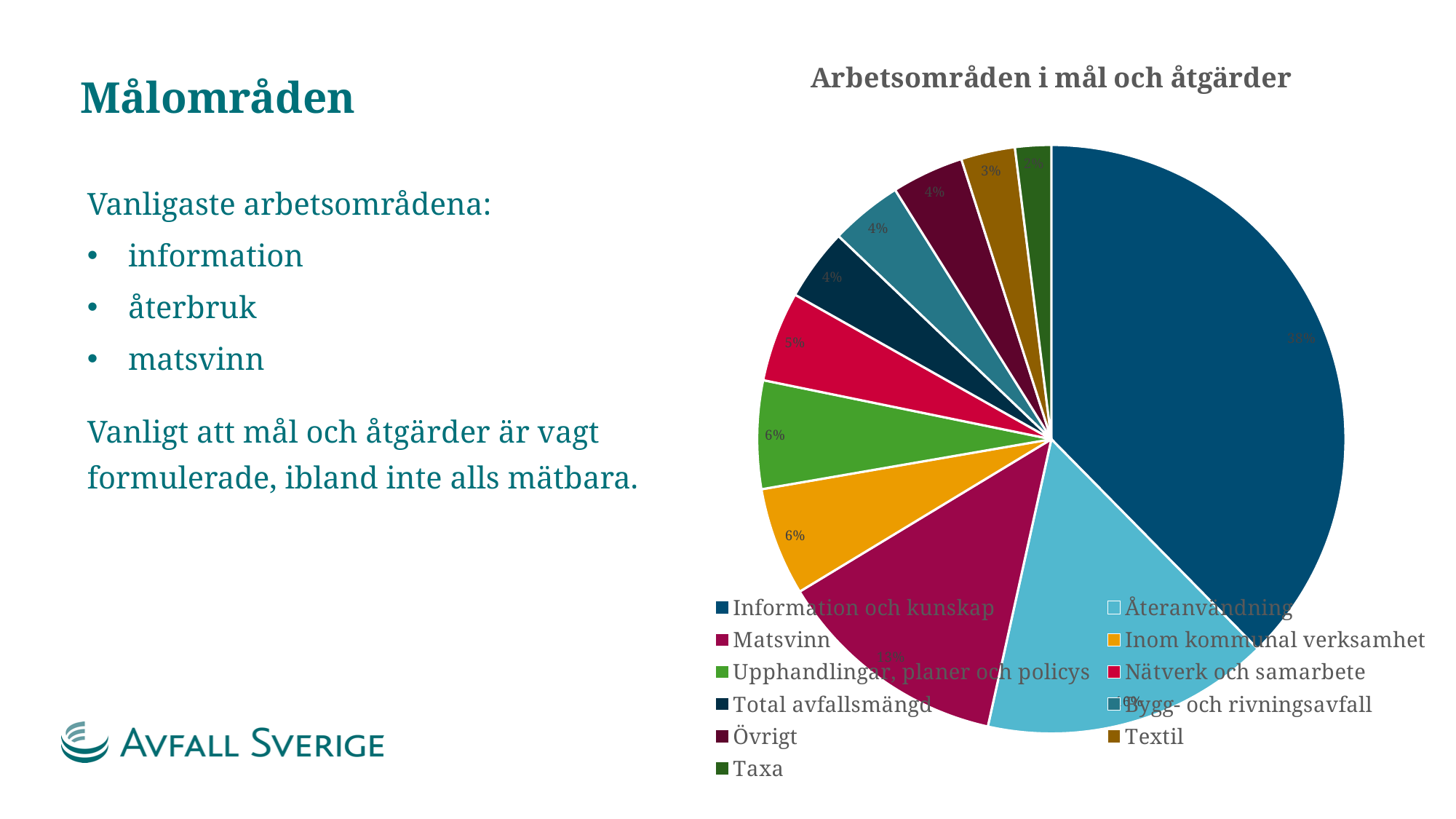
What share of the pie does Nätverk och samarbete have? 5% What is the title of the chart? Arbetsområden i mål och åtgärder What share of the pie does Information och kunskap have? 38% Which category has the largest share of the pie? Information och kunskap What share of the pie does Textil have? 3% How many categories does the pie chart have? 11 What share of the pie does Taxa have? 2% What is the difference in percentage points between Textil and Taxa? 1 Which is larger, the share for Återanvändning or the share for Matsvinn? Återanvändning Which category has the smallest share of the pie? Taxa What share of the pie does Inom kommunal verksamhet have? 6% What kind of chart is shown on the slide? pie chart